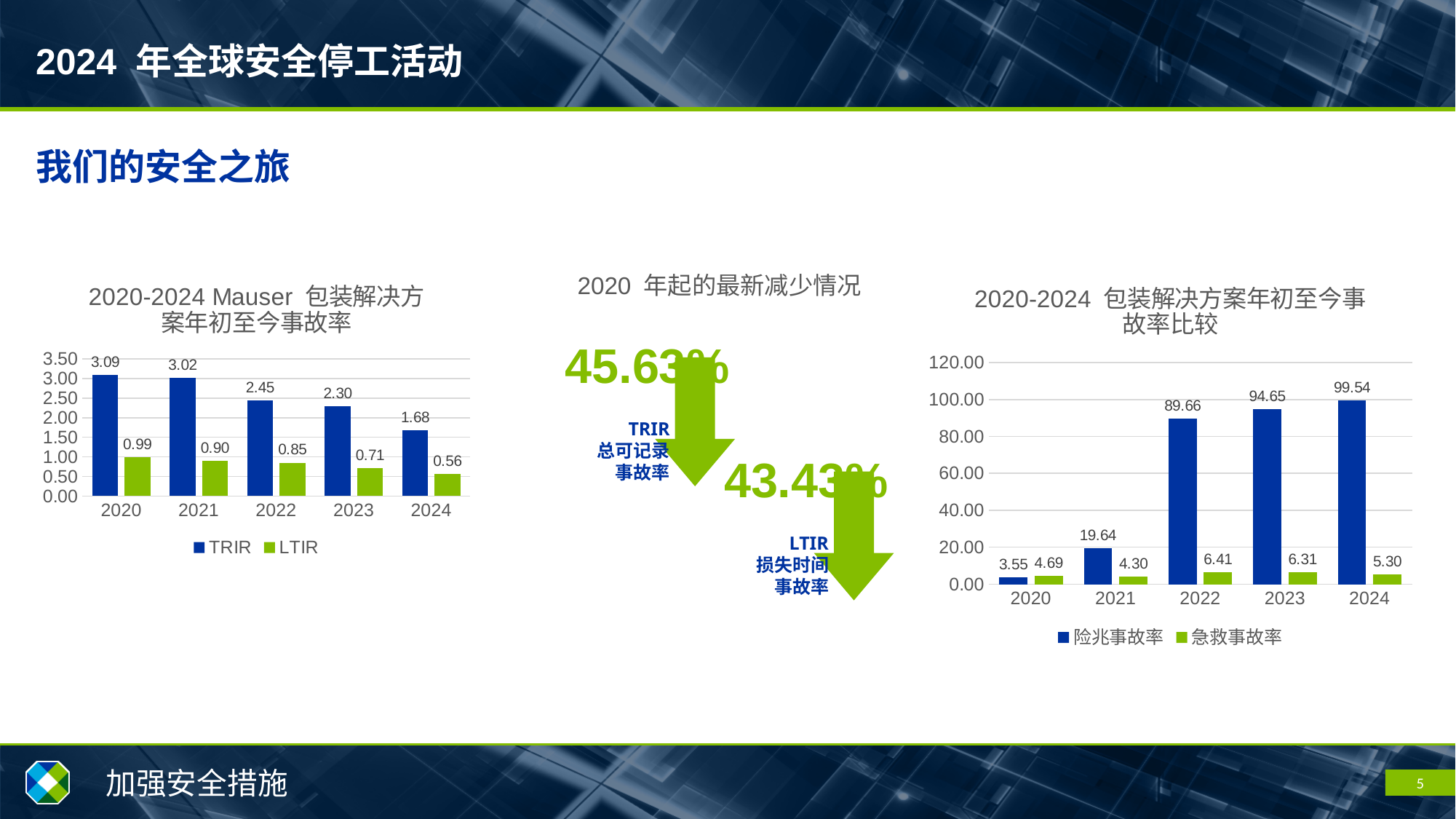
How many years are shown on the x axis of the right chart? 5 In the left chart, what is the difference between the TRIR values for 2020 and 2024? 1.41 What type of chart is the right chart? bar chart In the right chart, what is the 险兆事故率 value for 2023? 94.65 In the left chart, what is the TRIR value for 2022? 2.45 How many series does the legend of the left chart list? 2 In the left chart, what is the LTIR value for 2024? 0.56 In the right chart, which year has the lowest 险兆事故率 value? 2020 In the right chart, what is the 急救事故率 value for 2021? 4.30 In the left chart, which year has the highest TRIR value? 2020 In the right chart, which is larger for 2020: 险兆事故率 or 急救事故率? 急救事故率 In the left chart, do the TRIR values rise or fall from 2020 to 2024? fall